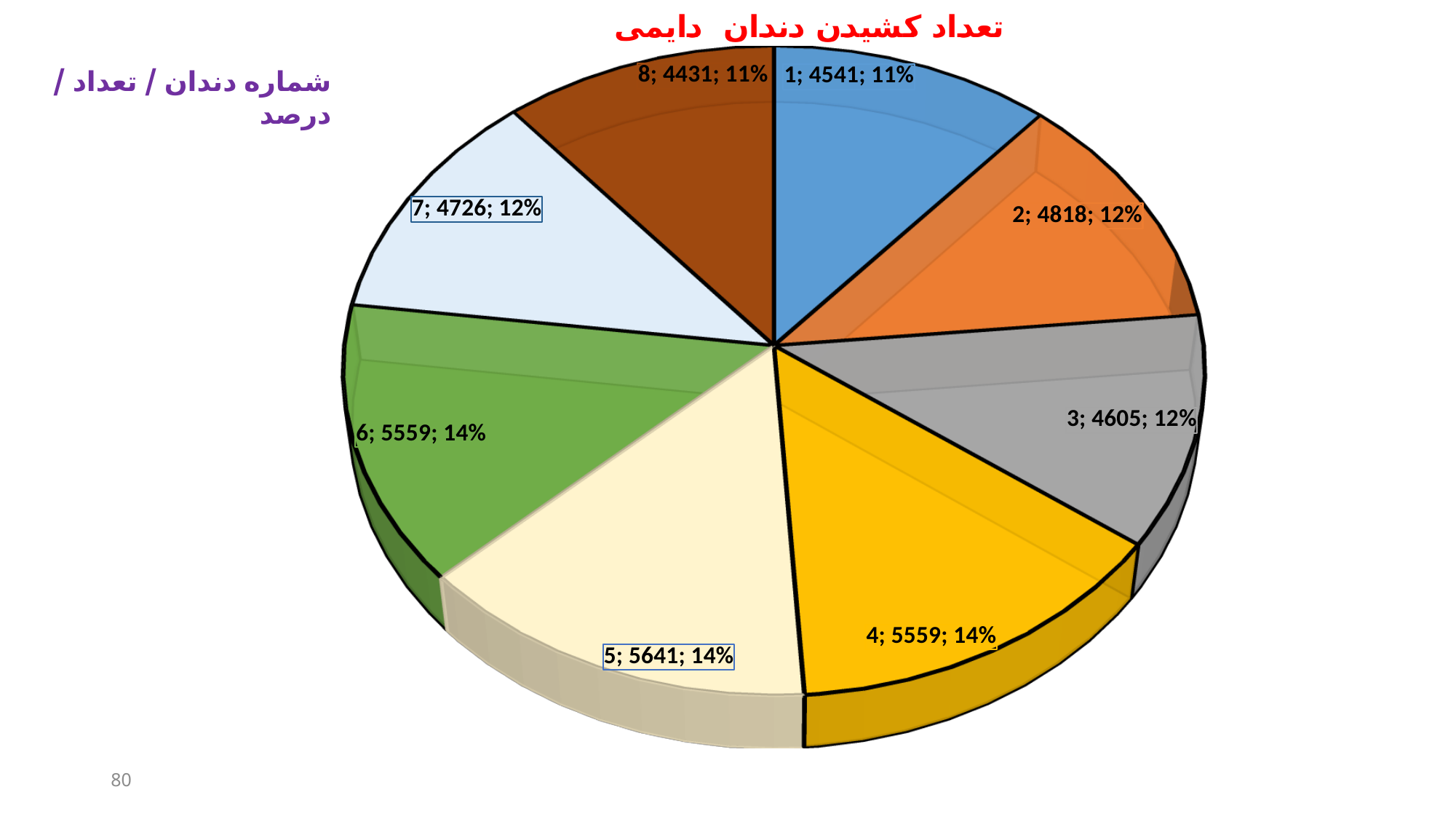
How many slices does the pie chart have? 8 Which has a larger count, tooth number 3 or tooth number 7? 7 What is the count shown for tooth number 5? 5641 What percentage share is shown for tooth number 1? 11% What kind of chart is shown on the slide? pie chart What is the difference between the counts for tooth number 2 and tooth number 1? 277 What percentage share is shown for tooth number 7? 12% What is the title of the chart? تعداد کشیدن دندان دایمی Which tooth number has the lowest count? 8 Which tooth number has the highest count? 5 What is the count shown for tooth number 2? 4818 What is the difference between the counts for tooth number 5 and tooth number 8? 1210